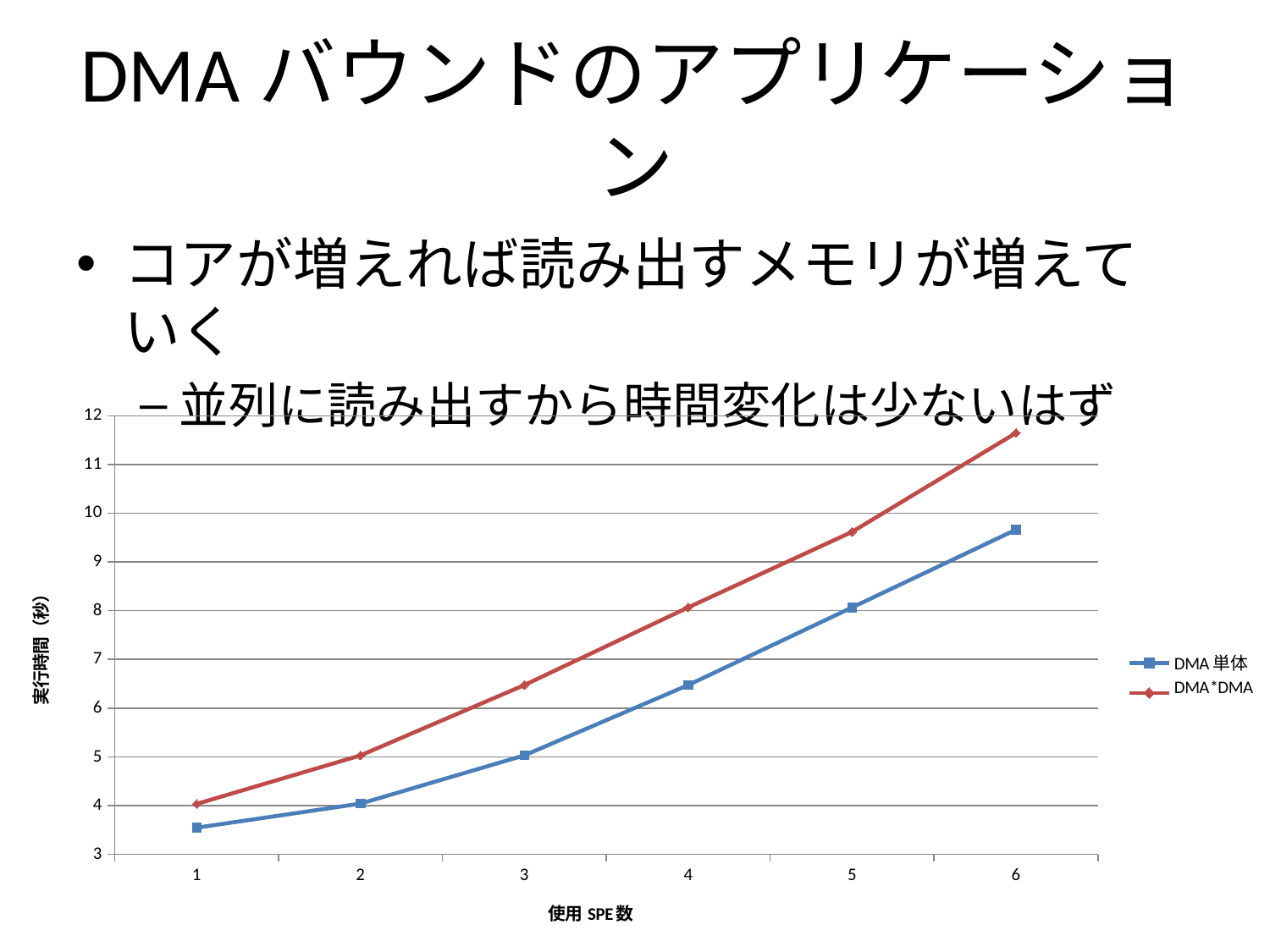
Is the value for DMA 単体 at 使用 SPE 数 = 6 greater or less than 10? less Is the value for DMA*DMA at 使用 SPE 数 = 6 greater or less than 11? greater What is the title of the y axis of the chart? 実行時間（秒） Do the values of the DMA 単体 series rise or fall as 使用 SPE 数 increases? rise How many points along the x axis (使用 SPE 数) does each series have? 6 At 使用 SPE 数 = 6, which series has the larger 実行時間, DMA 単体 or DMA*DMA? DMA*DMA Is the value for DMA 単体 at 使用 SPE 数 = 1 greater or less than 4? less Do the values of the DMA*DMA series rise or fall as 使用 SPE 数 increases? rise At which 使用 SPE 数 is the 実行時間 of the DMA*DMA series highest? 6 At which 使用 SPE 数 is the 実行時間 of the DMA 単体 series lowest? 1 How many series does the chart legend list? 2 What kind of chart is shown on the slide? line chart